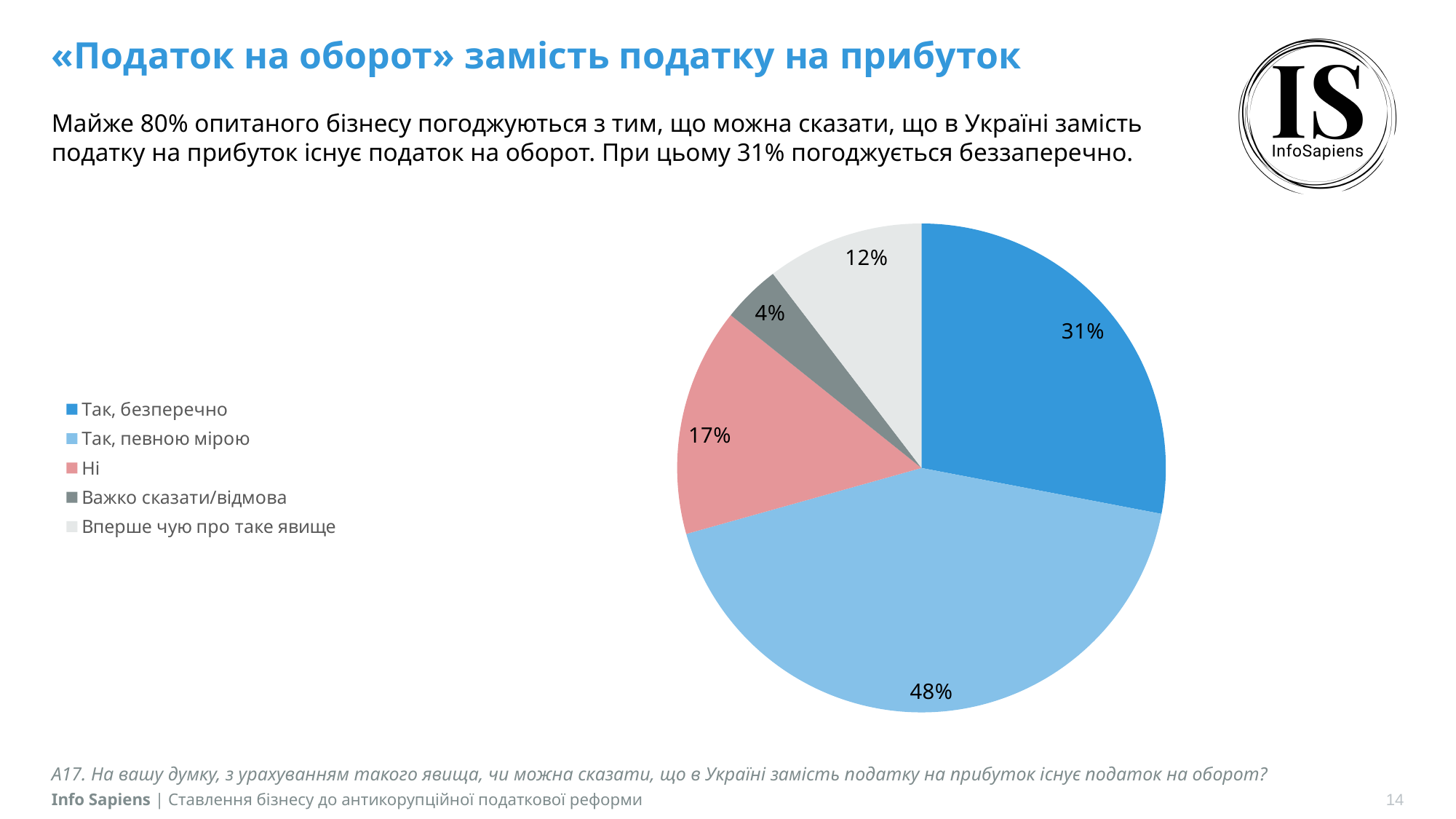
What share of the pie is labelled "Ні"? 17% Which is larger: the share for "Ні" or the share for "Вперше чую про таке явище"? Ні What is the combined share of "Так, безперечно" and "Так, певною мірою"? 79% How many categories does the pie chart have? 5 What share of the pie is labelled "Важко сказати/відмова"? 4% What kind of chart is shown on the slide? pie chart What share of the pie is labelled "Так, безперечно"? 31% What share of the pie is labelled "Так, певною мірою"? 48% Which category has the largest slice of the pie? Так, певною мірою Which category has the smallest slice of the pie? Важко сказати/відмова What is the difference between the shares for "Так, певною мірою" and "Так, безперечно"? 17% What share of the pie is labelled "Вперше чую про таке явище"? 12%